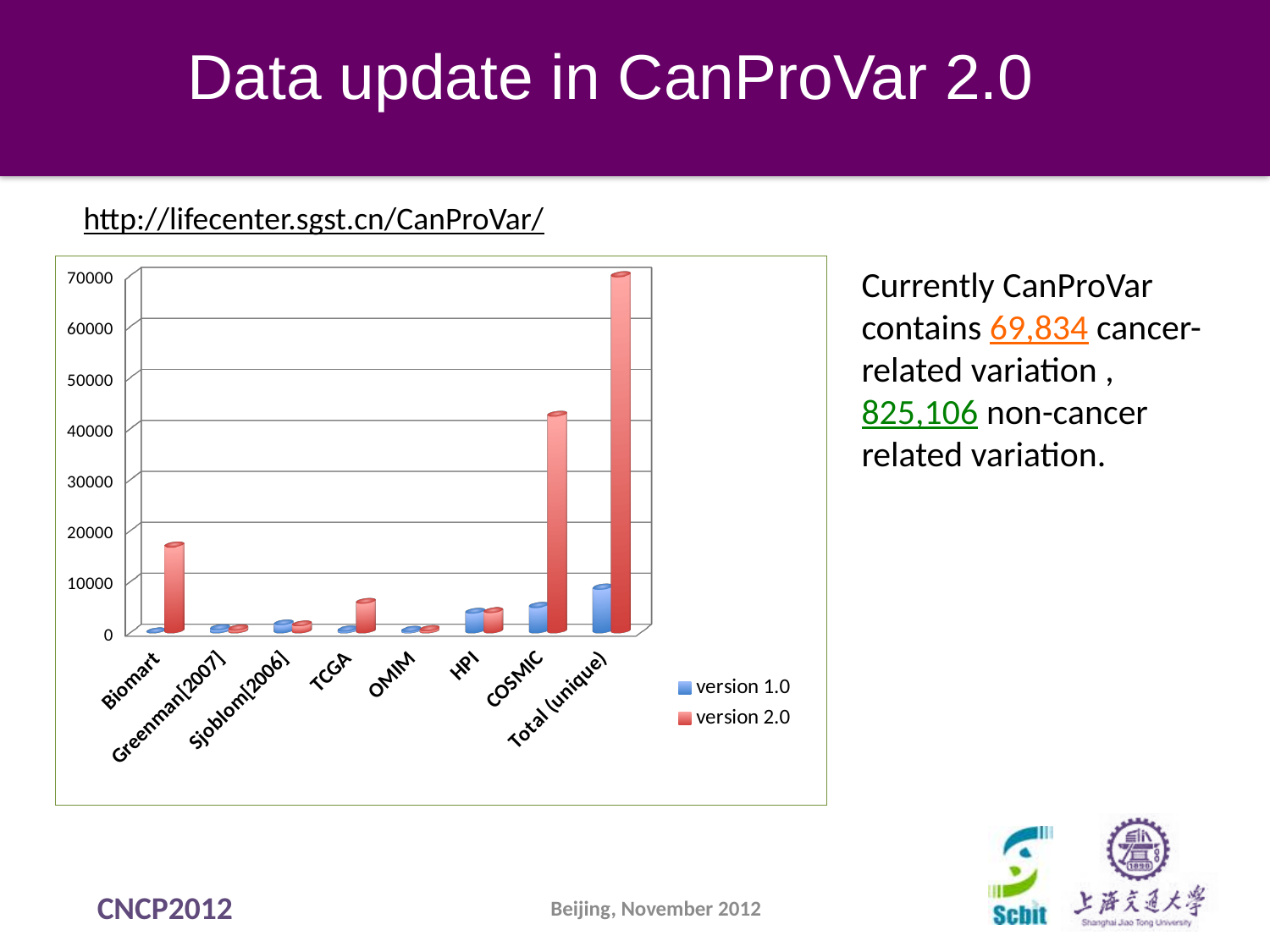
For Total (unique), which series has the larger value, version 1.0 or version 2.0? version 2.0 Which category has the highest version 2.0 value? Total (unique) What kind of chart is shown on the slide? bar chart Which is larger, the version 2.0 value for COSMIC or the version 2.0 value for Biomart? COSMIC Is the version 2.0 value for Total (unique) greater or less than 60000? greater What colour are the version 2.0 bars in the chart? red How many series does the chart's legend list? 2 Is the version 1.0 value for Total (unique) greater or less than 20000? less How many categories are shown on the x axis of the chart? 8 Is the version 2.0 value for Biomart greater or less than 10000? greater Which category has the highest version 1.0 value? Total (unique)